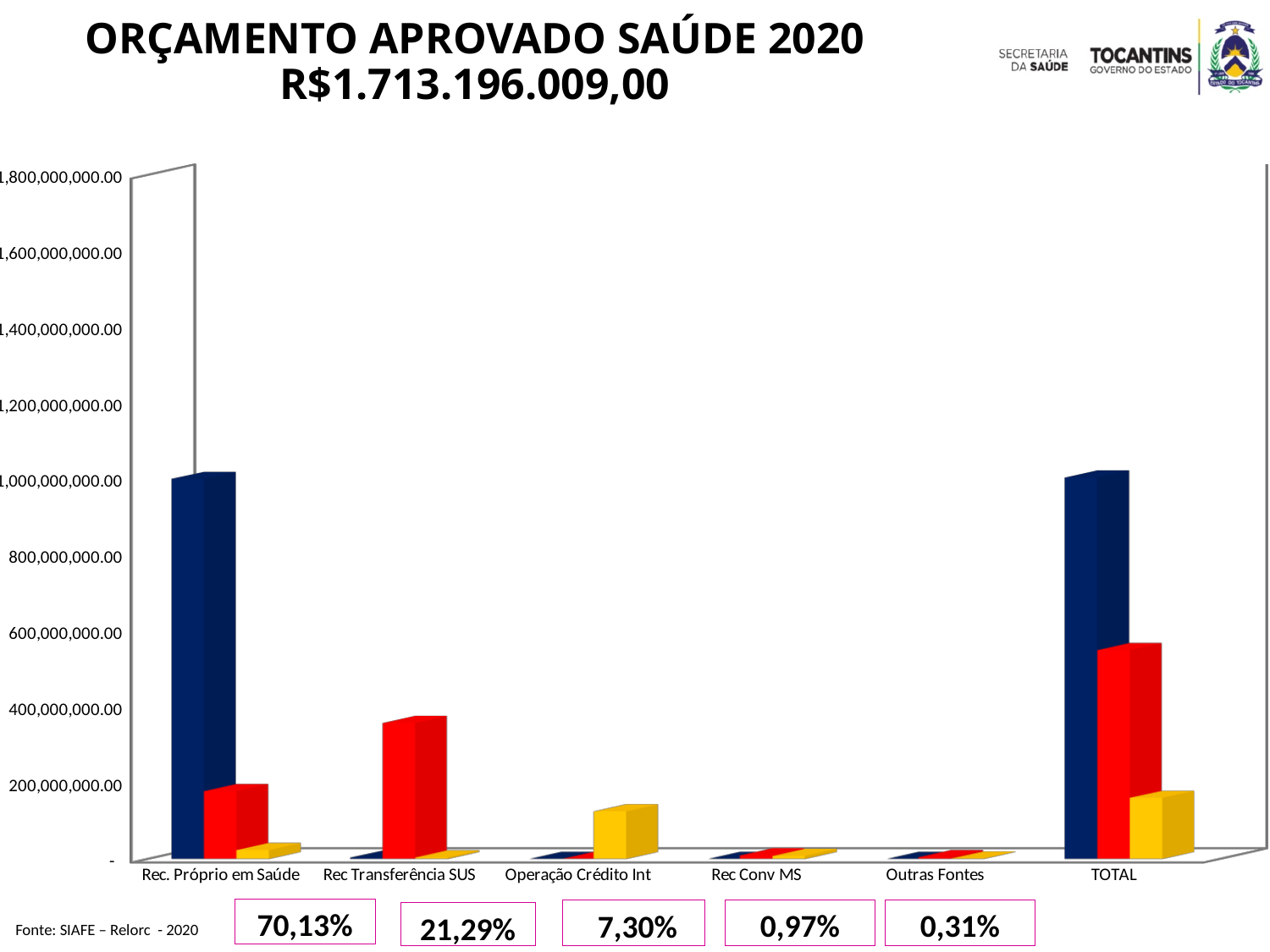
Is the value of the dark blue bar for Rec. Próprio em Saúde greater or less than 800,000,000.00? greater How many categories are shown on the x axis of the chart? 6 What kind of chart is shown on the slide? bar chart Is the value of the red bar for Rec Transferência SUS greater or less than 400,000,000.00? less Which category has the tallest red bar? TOTAL Is the value of the yellow bar for Operação Crédito Int greater or less than 200,000,000.00? less What is the title of the chart on the slide? ORÇAMENTO APROVADO SAÚDE 2020 R$1.713.196.009,00 What percentage is printed below the Rec. Próprio em Saúde category? 70,13% For Rec. Próprio em Saúde, which bar is taller, the dark blue one or the red one? the dark blue one How many bars are plotted for each category in the chart? 3